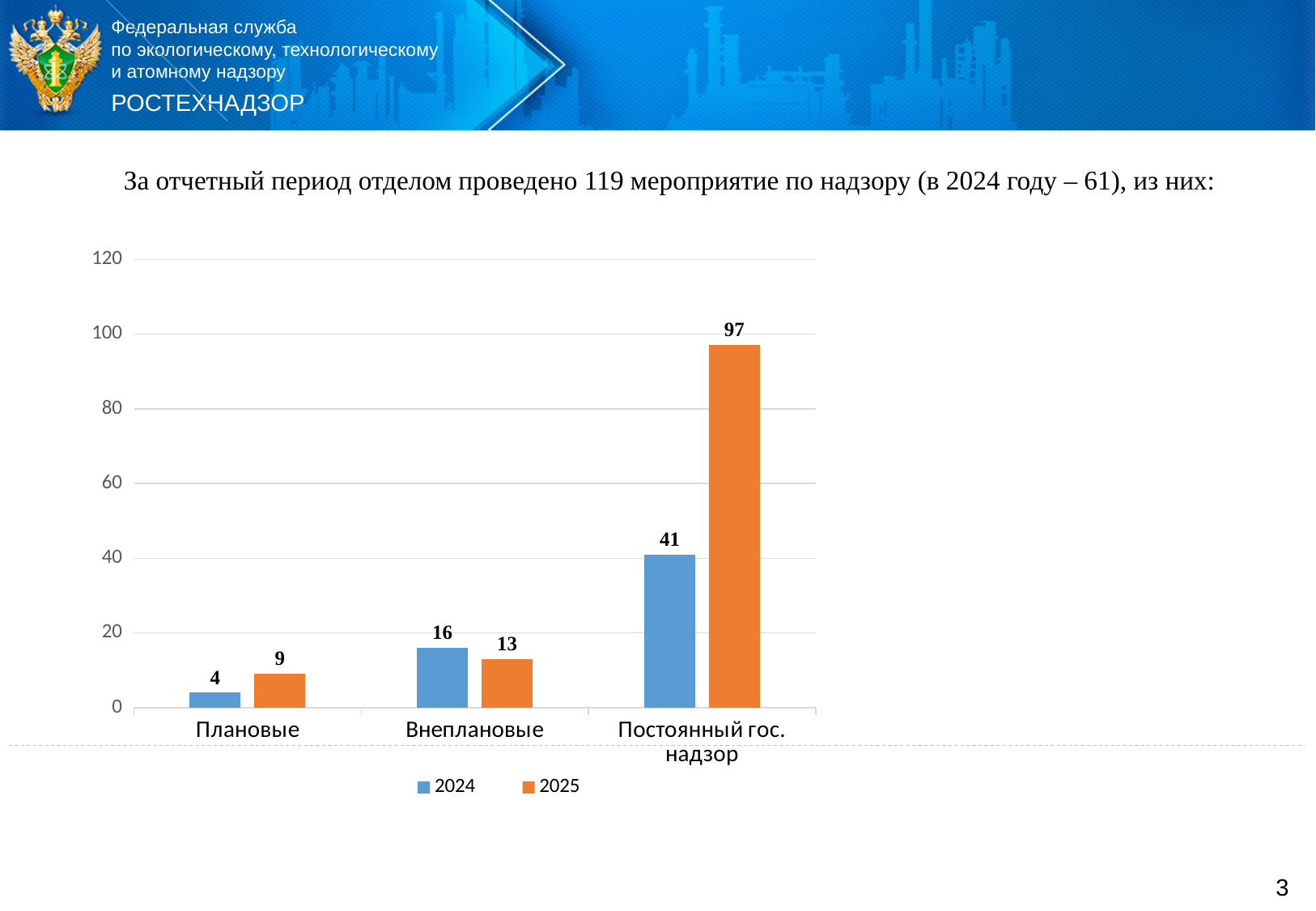
What kind of chart is shown on the slide? bar chart Is the 2025 value for Постоянный гос. надзор greater or less than 80? greater What is the value for Плановые in the 2024 series? 4 What is the difference between the 2025 and 2024 values for Постоянный гос. надзор? 56 What is the value for Постоянный гос. надзор in the 2025 series? 97 What is the value for Внеплановые in the 2025 series? 13 How many categories are shown on the x axis? 3 Which colour represents the 2025 series in the legend? orange Which is larger for Внеплановые: the 2024 value or the 2025 value? 2024 Which category has the highest value in the 2025 series? Постоянный гос. надзор How many series does the legend list? 2 Which category has the lowest value in the 2024 series? Плановые